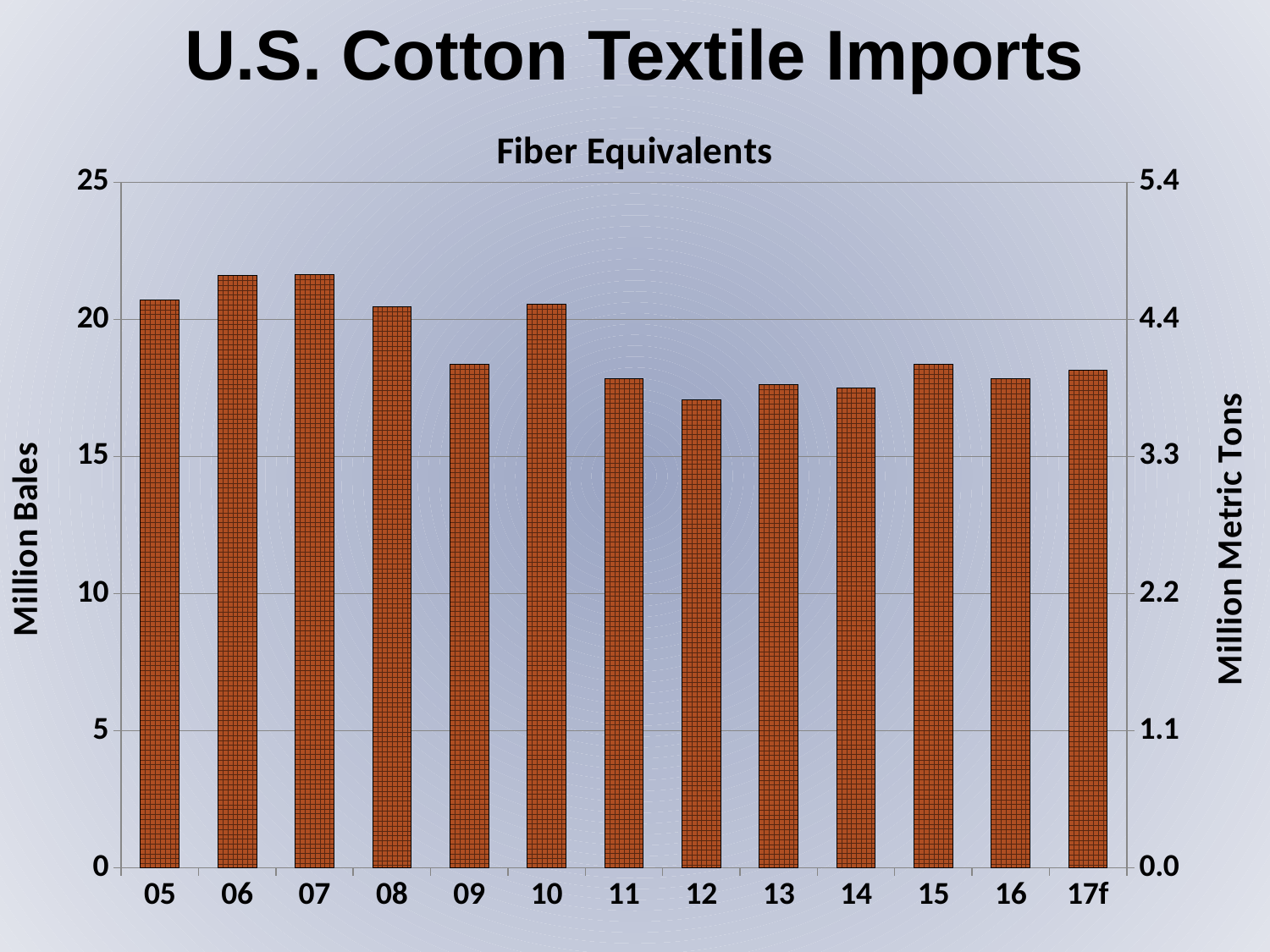
What is the label of the left vertical axis? Million Bales Which is larger, the value for 05 or the value for 09? 05 Which is larger, the value for 10 or the value for 12? 10 Is the value for 09 greater or less than 20 million bales? less Is the value for 15 greater or less than 15 million bales? greater Is the value for 12 greater or less than 20 million bales? less What is the label of the right vertical axis? Million Metric Tons Which year has the lowest cotton textile imports? 12 Overall, do the values rise or fall from 05 to 17f? fall What kind of chart is shown on the slide? bar chart How many years (categories) are plotted on the x axis? 13